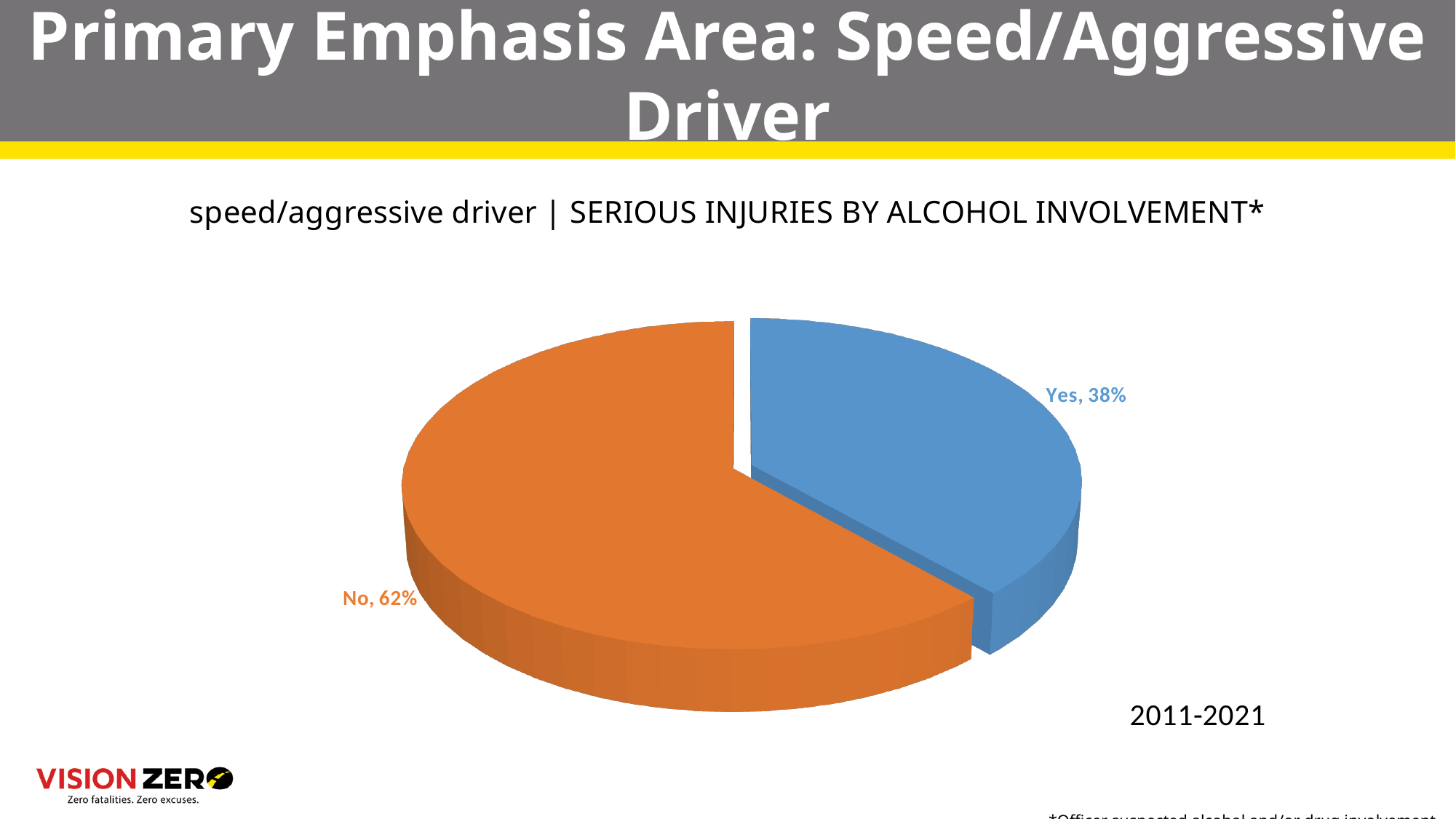
What is the title of the chart? speed/aggressive driver | SERIOUS INJURIES BY ALCOHOL INVOLVEMENT* Which slice of the pie is the largest? No What kind of chart is shown on the slide? Pie chart What share of serious injuries involved alcohol (Yes)? 38% Which slice of the pie is the smallest? Yes What share of serious injuries did not involve alcohol (No)? 62% What colour is the Yes slice? Blue Which is larger, the Yes slice or the No slice? No What is the difference in percentage points between the No and Yes slices? 24 How many slices does the pie chart have? 2 What time period does the chart cover? 2011-2021